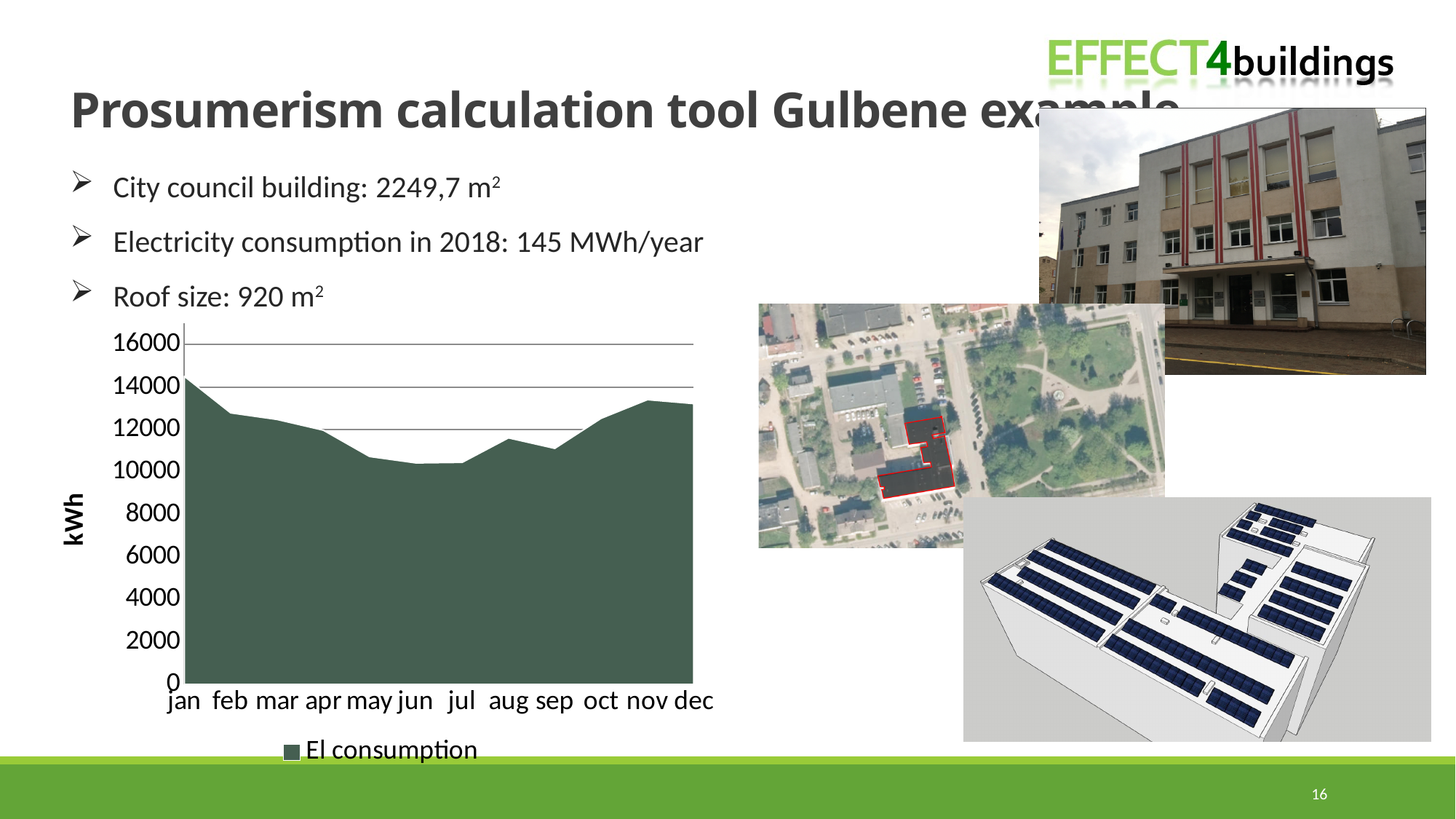
Does the electricity consumption rise or fall from jan to jun? fall How many series does the chart's legend list? 1 What series name is shown in the chart's legend? El consumption Which month has the larger electricity consumption, jan or jul? jan Which month has the highest electricity consumption in the chart? jan Is the value for jul greater or less than 14000? less What is the label on the y axis of the chart? kWh What kind of chart is shown on the slide? area chart How many months are plotted along the x axis of the chart? 12 Is the value for nov greater or less than 12000? greater Is the value for jan greater or less than 12000? greater